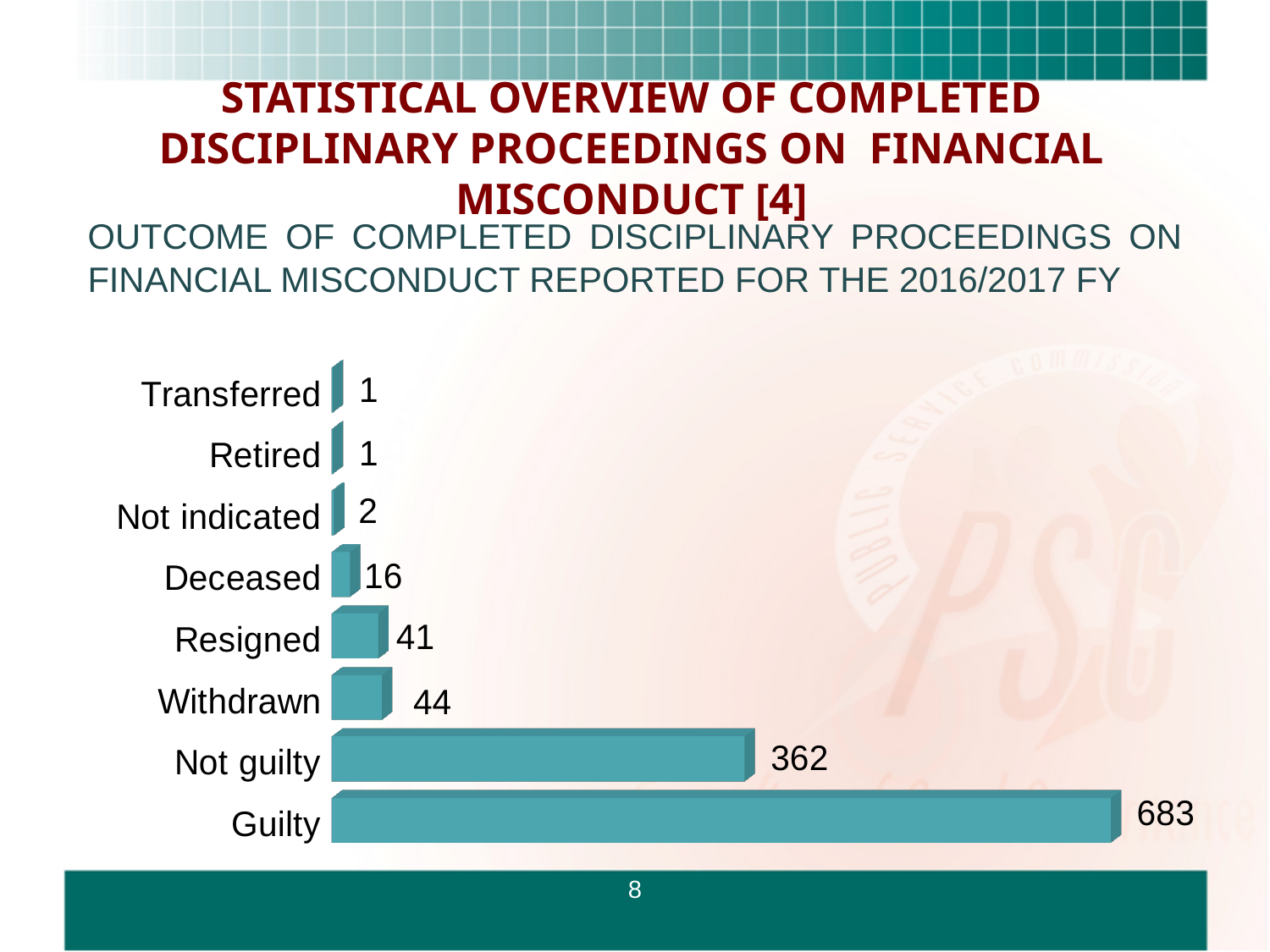
What is the value for Not guilty? 362 What is the value for Not indicated? 2 What is the value for Guilty? 683 What is the value for Withdrawn? 44 Which category has the highest value? Guilty Which financial year does the chart report on? 2016/2017 FY How many categories are shown in the chart? 8 What kind of chart is shown on the slide? Bar chart What is the difference between the values for Guilty and Not guilty? 321 What is the value for Deceased? 16 What is the difference between the values for Withdrawn and Resigned? 3 Which is larger, the value for Resigned or the value for Deceased? Resigned